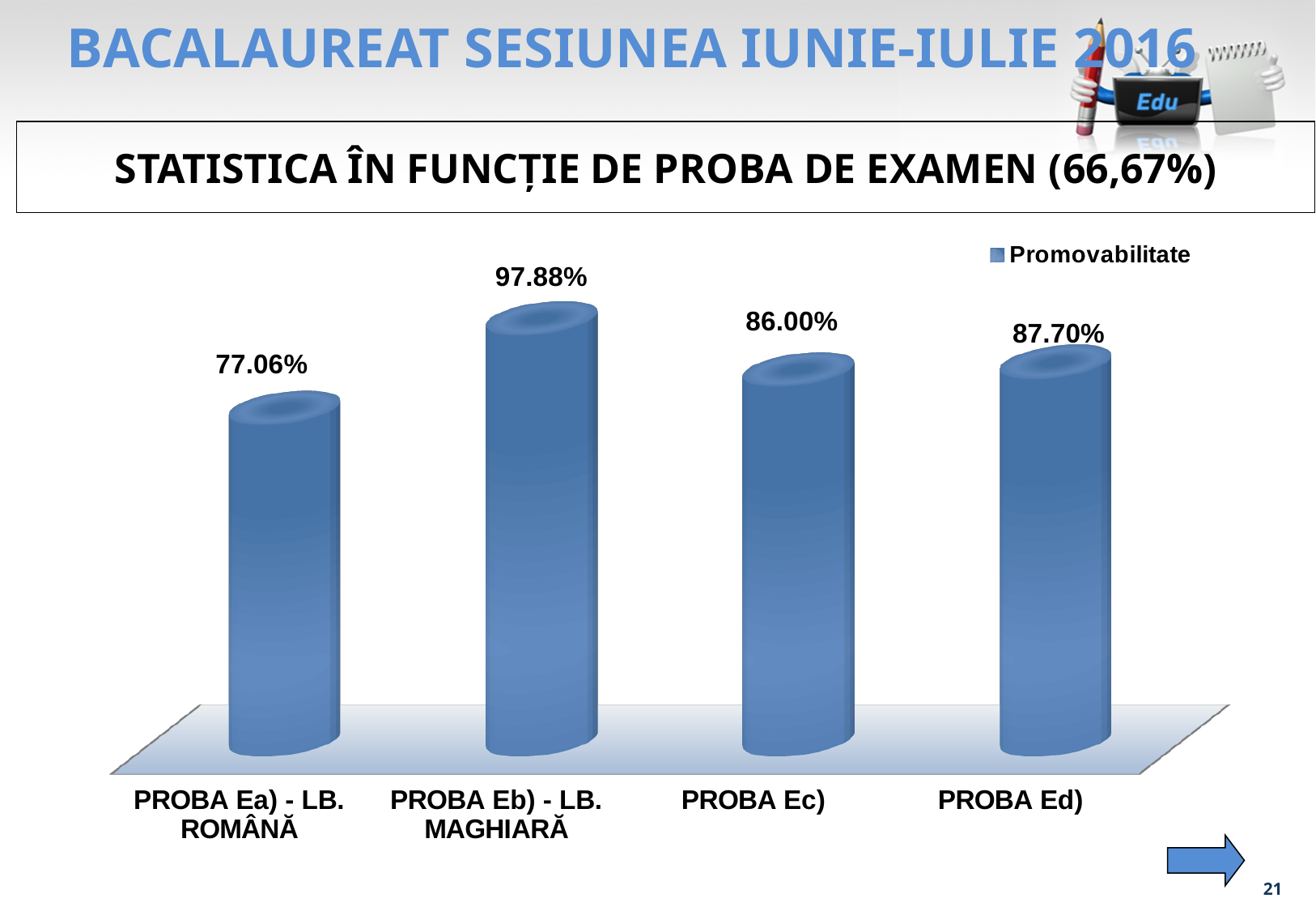
How many exam categories are shown in the chart? 4 What is the difference in Promovabilitate between PROBA Ed) and PROBA Ec)? 1.70% What is the Promovabilitate value for PROBA Ec)? 86.00% What is the Promovabilitate value for PROBA Eb) - LB. MAGHIARĂ? 97.88% What is the difference in Promovabilitate between PROBA Eb) - LB. MAGHIARĂ and PROBA Ea) - LB. ROMÂNĂ? 20.82% What is the Promovabilitate value for PROBA Ea) - LB. ROMÂNĂ? 77.06% Which exam has the highest Promovabilitate? PROBA Eb) - LB. MAGHIARĂ What kind of chart is shown on the slide? Bar chart How many series does the legend list? 1 Which exam has the lowest Promovabilitate? PROBA Ea) - LB. ROMÂNĂ What is the Promovabilitate value for PROBA Ed)? 87.70% Which has a higher Promovabilitate, PROBA Ec) or PROBA Ed)? PROBA Ed)